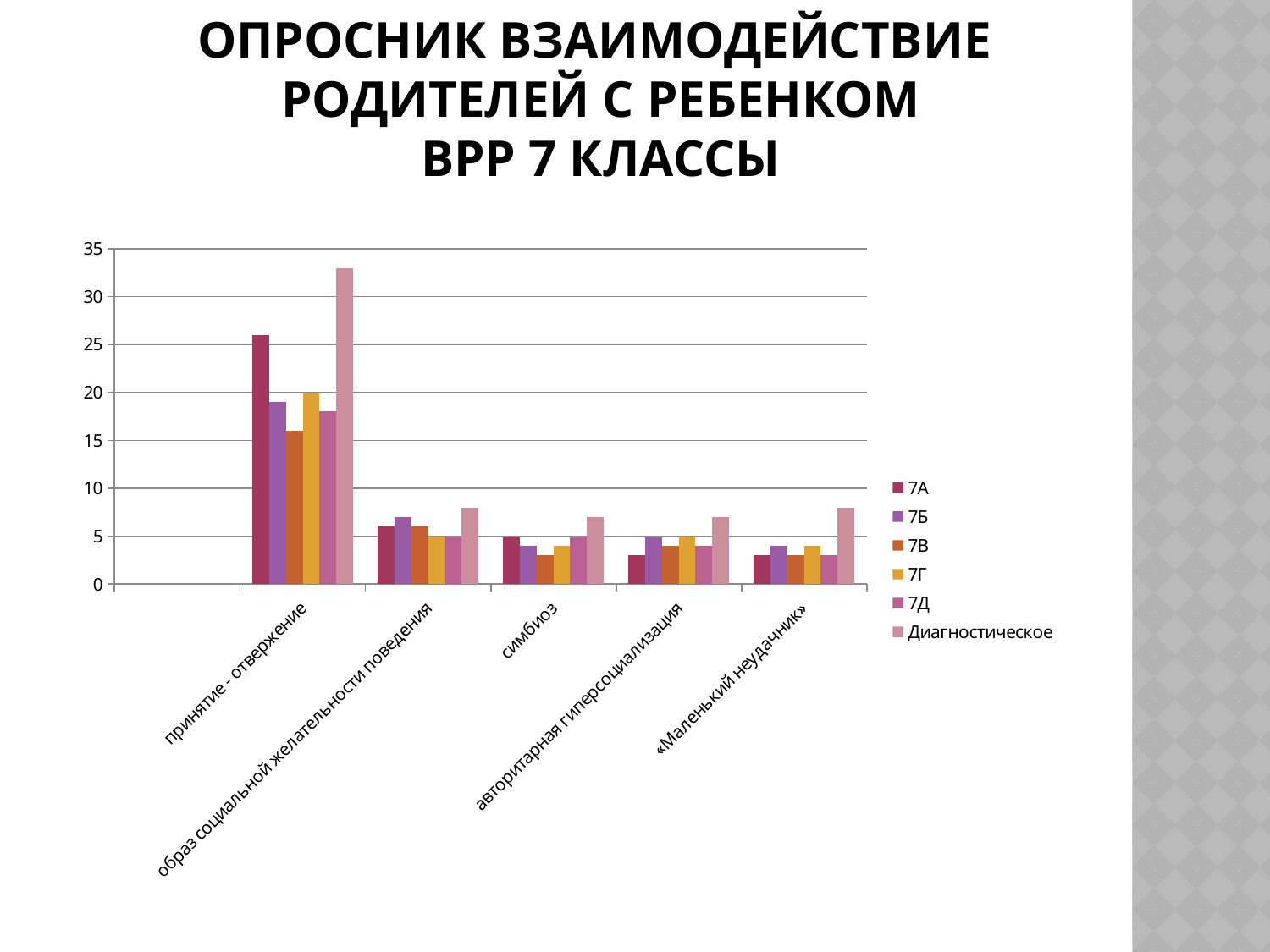
Which series has the lowest value for the category "принятие - отвержение"? 7В Which series is listed last in the chart legend? Диагностическое Which is larger in the category "принятие - отвержение": the value for "7А" or the value for "7Б"? 7А How many categories are shown on the x axis of the chart? 5 Which series has the highest value for the category "принятие - отвержение"? Диагностическое Is the value for "7А" in the category "принятие - отвержение" greater or less than 20? greater Which is larger in the category "симбиоз": the value for "Диагностическое" or the value for "7Д"? Диагностическое Is the value for "Диагностическое" in the category "принятие - отвержение" greater or less than 30? greater Which category has the tallest bar in the whole chart? принятие - отвержение What kind of chart is shown on the slide? bar chart Is the value for "7В" in the category "принятие - отвержение" greater or less than 20? less How many series does the chart legend list? 6